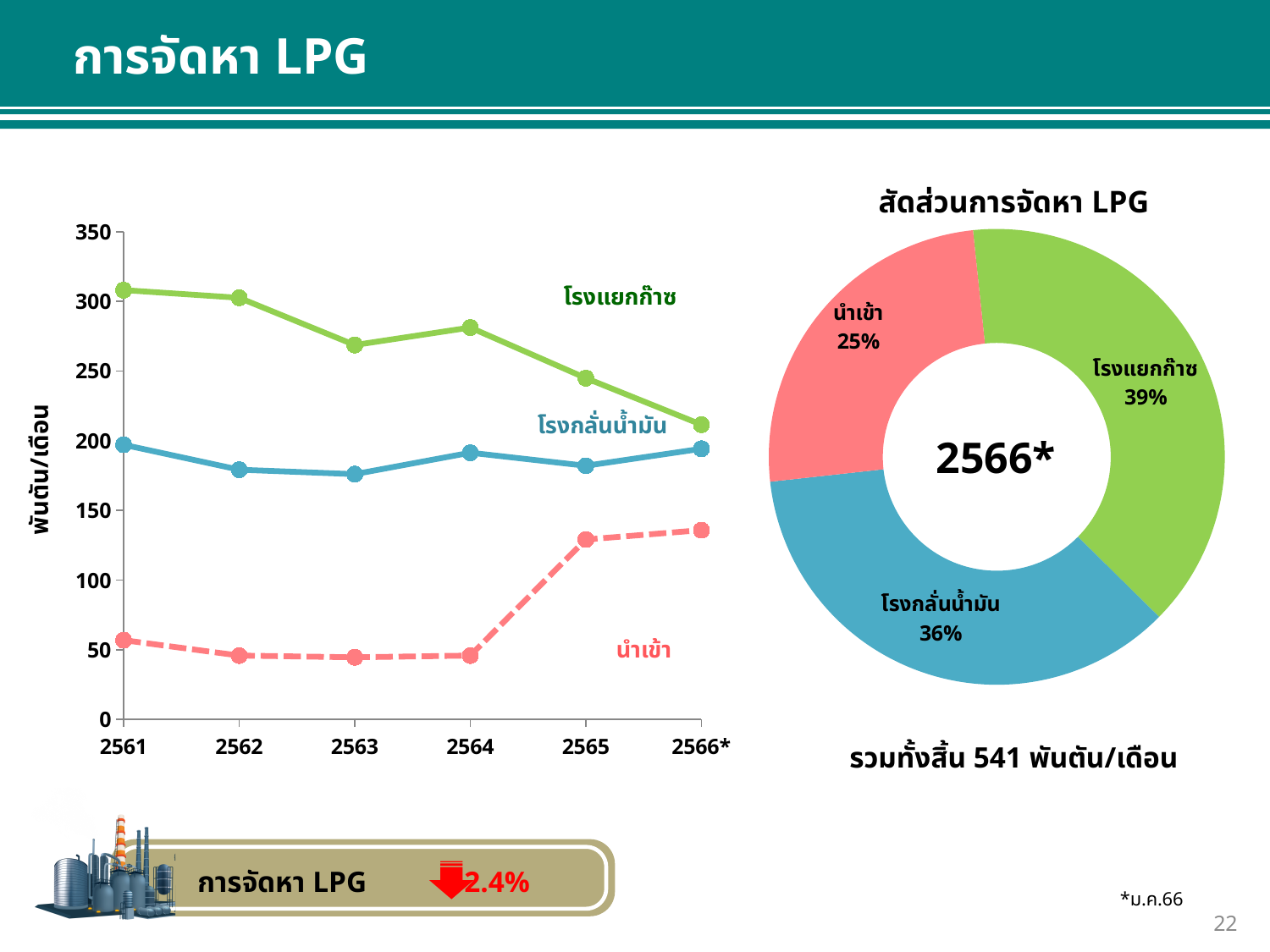
In the line chart on the left, is the value for โรงแยกก๊าซ in 2561 greater or less than 300? greater In the donut chart สัดส่วนการจัดหา LPG, which source has the smallest share? นำเข้า In the donut chart สัดส่วนการจัดหา LPG, what share does โรงแยกก๊าซ have? 39% In the line chart on the left, how many series are plotted? 3 What kind of chart is the chart on the left of the slide? line chart In the line chart on the left, how many years are shown on the x axis? 6 In the line chart on the left, which is larger in 2561: โรงกลั่นน้ำมัน or นำเข้า? โรงกลั่นน้ำมัน In the line chart on the left, does the โรงแยกก๊าซ series rise or fall from 2561 to 2566*? fall In the line chart on the left, is the value for นำเข้า in 2563 greater or less than 100? less In the donut chart สัดส่วนการจัดหา LPG, what is the difference in percentage points between โรงแยกก๊าซ and โรงกลั่นน้ำมัน? 3 In the line chart on the left, which series has the highest value in 2566*? โรงแยกก๊าซ In the line chart on the left, is the value for โรงกลั่นน้ำมัน in 2563 greater or less than 200? less